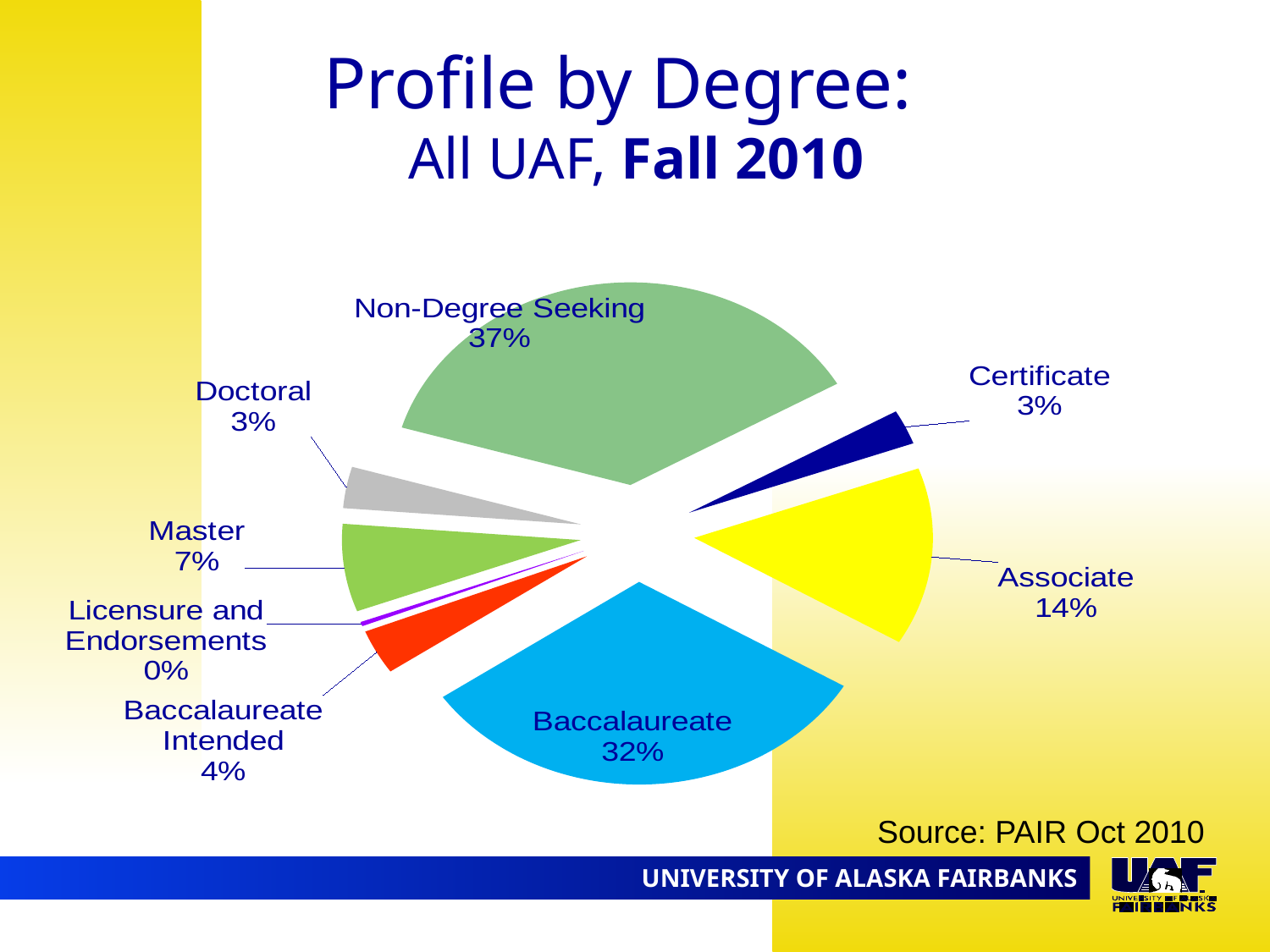
What is the difference in percentage points between Non-Degree Seeking and Baccalaureate? 5 What percentage is shown for Licensure and Endorsements? 0% Which is larger, Associate or Master? Associate What percentage is shown for Baccalaureate? 32% What percentage is shown for Master? 7% How many categories are shown in the pie chart? 8 What is the title of the chart on the slide? Profile by Degree: All UAF, Fall 2010 Which category has the smallest share of the pie? Licensure and Endorsements Which category has the largest share of the pie? Non-Degree Seeking What percentage is shown for Associate? 14% What share of the pie is Non-Degree Seeking? 37% What kind of chart is shown on the slide? Pie chart